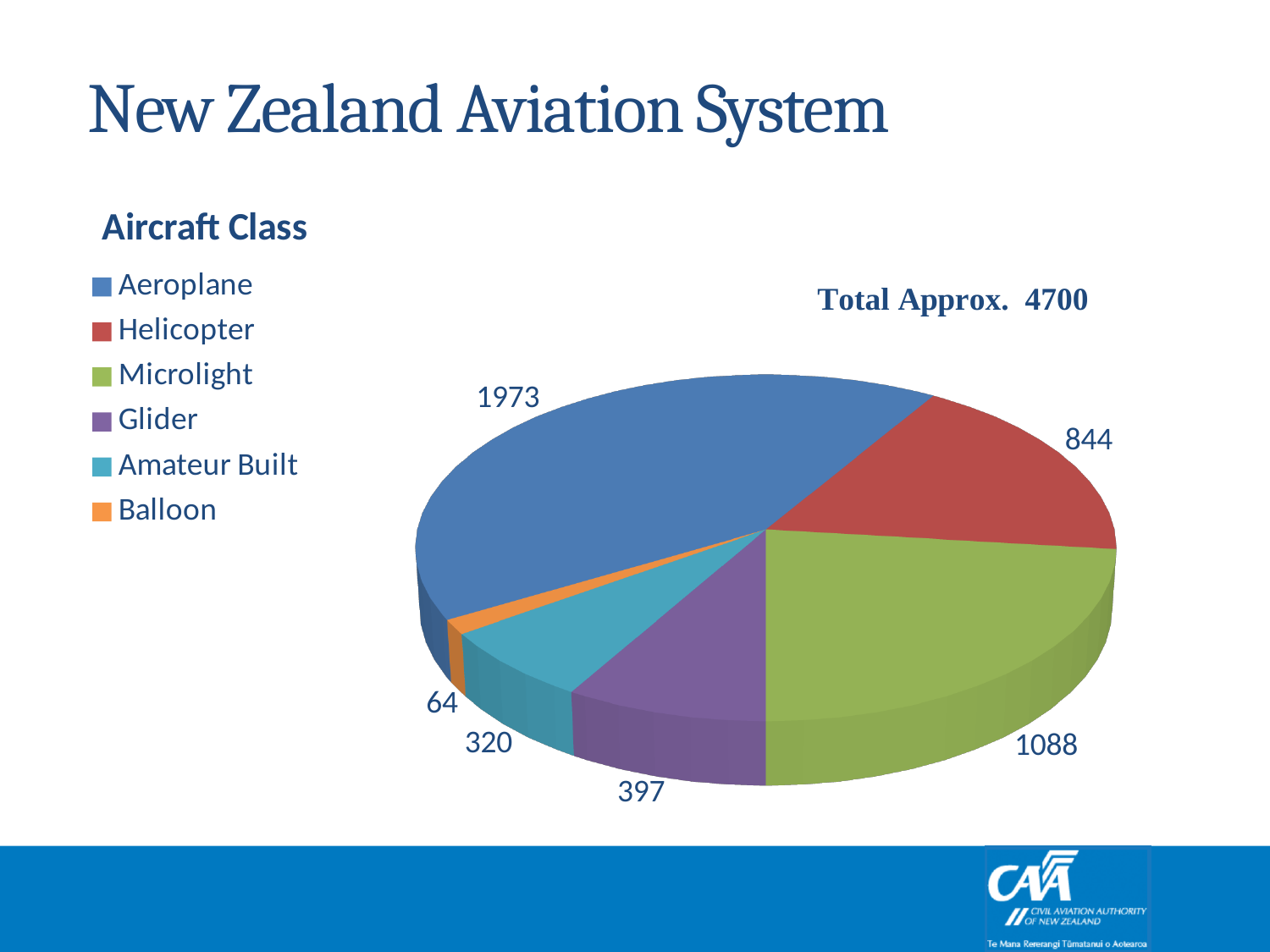
How many aircraft classes does the legend list? 6 What is the value for Glider? 397 What type of chart is shown on the slide? pie chart What is the value for Microlight? 1088 Which aircraft class has the largest slice? Aeroplane What is the value for Balloon? 64 What is the value for Aeroplane? 1973 What is the difference between the Aeroplane and Microlight values? 885 What is the value for Helicopter? 844 What is the value for Amateur Built? 320 Which aircraft class has the smallest slice? Balloon Which is larger, Helicopter or Glider? Helicopter